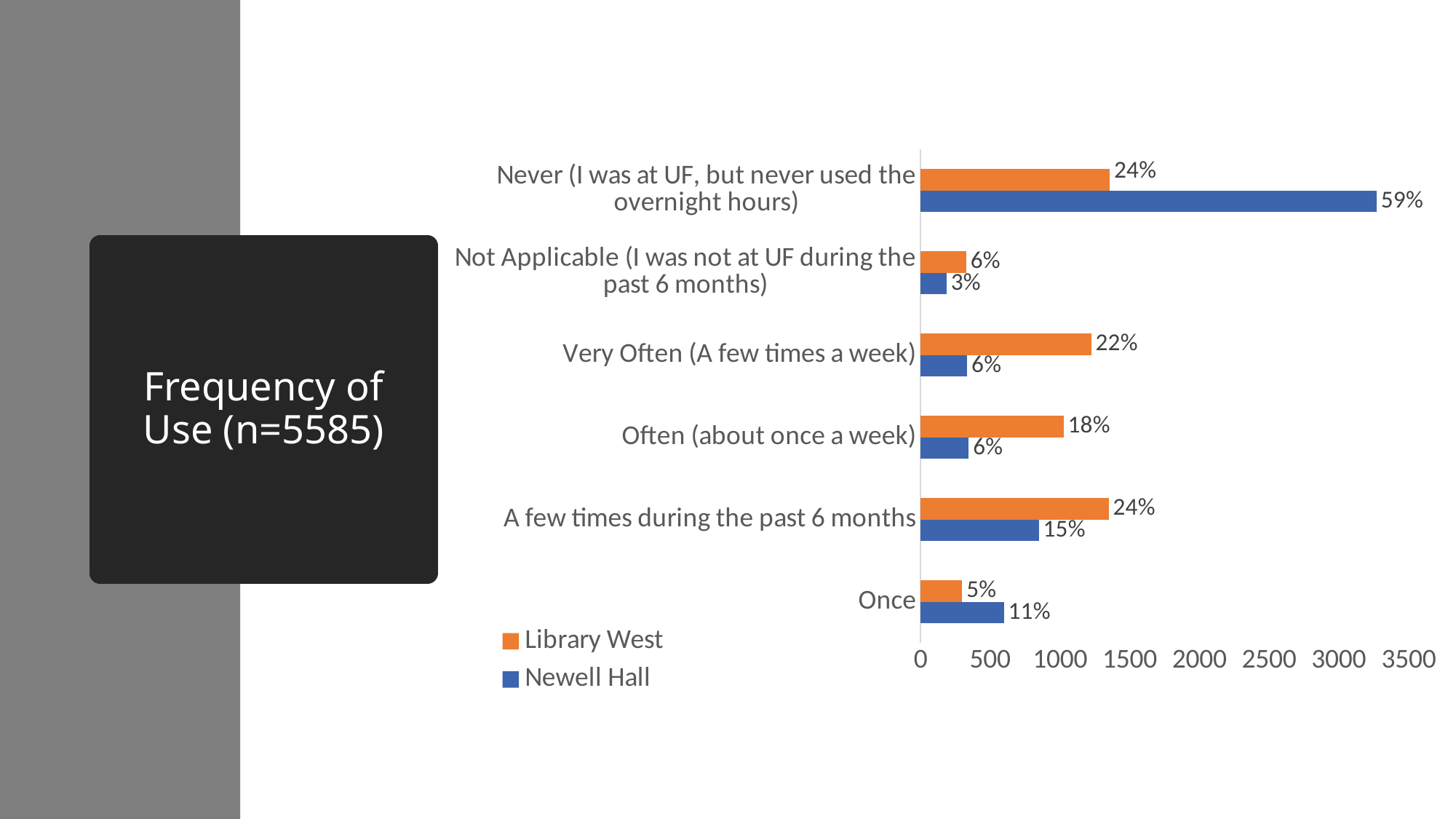
In the "Once" category, which series has the larger value, Library West or Newell Hall? Newell Hall What is the data label for Library West in the "Very Often (A few times a week)" category? 22% What is the data label for Library West in the "Often (about once a week)" category? 18% How many categories are shown on the chart? 6 What is the data label for Newell Hall in the "Never (I was at UF, but never used the overnight hours)" category? 59% How many series does the legend list? 2 Which category has the highest value for Newell Hall? Never (I was at UF, but never used the overnight hours) What is the data label for Newell Hall in the "Once" category? 11% Which category has the lowest value for Library West? Once Is the Newell Hall bar for "Never (I was at UF, but never used the overnight hours)" greater or less than 3000 on the axis? greater In the "Never" category, how many percentage points higher is Newell Hall's label than Library West's? 35 percentage points What kind of chart is shown on the slide? Bar chart